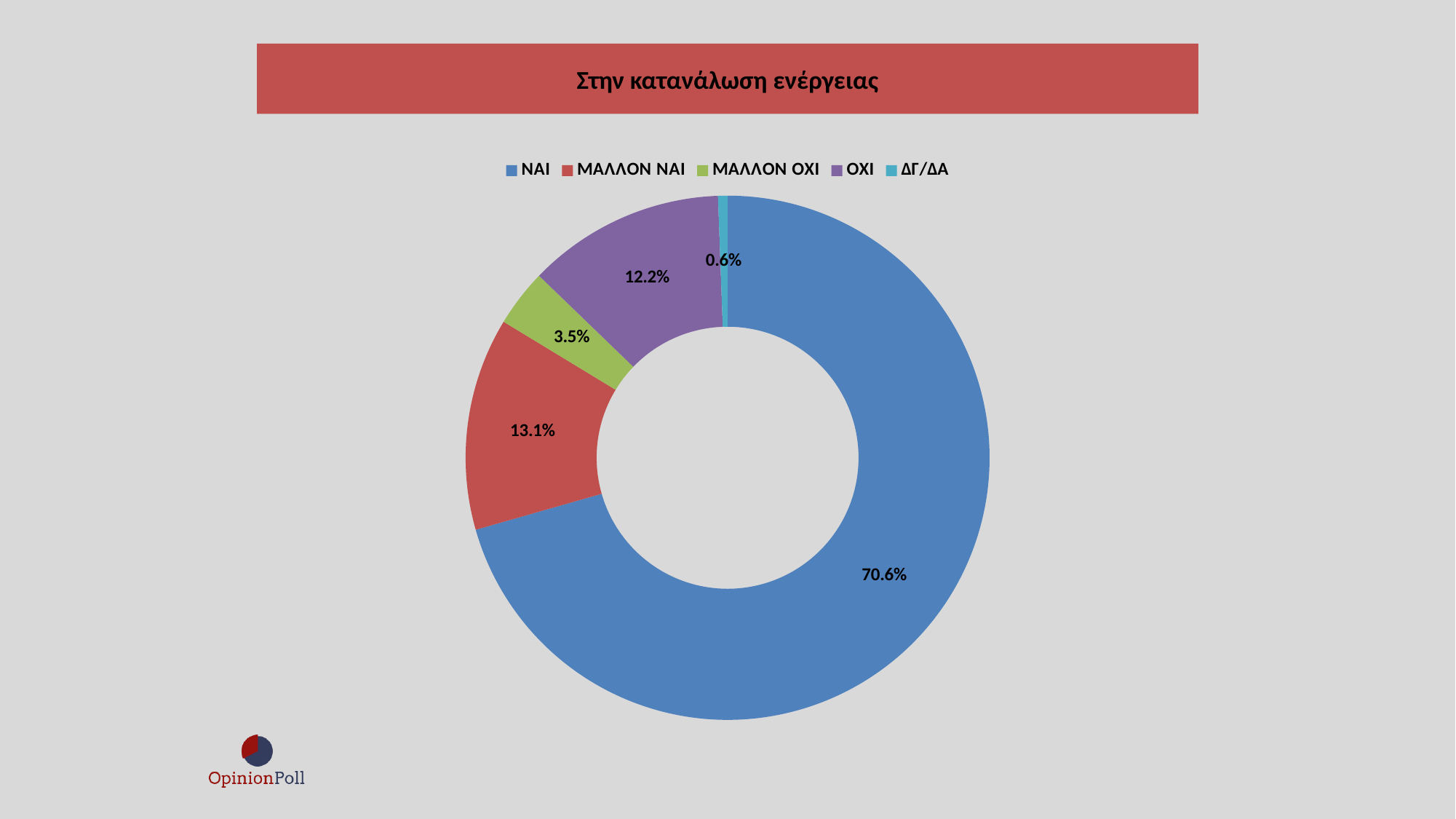
What percentage is shown for ΝΑΙ? 70.6% Which category has the largest share? ΝΑΙ What percentage is shown for ΜΑΛΛΟΝ ΟΧΙ? 3.5% What percentage is shown for ΔΓ/ΔΑ? 0.6% What percentage is shown for ΟΧΙ? 12.2% Which is larger, the share for ΜΑΛΛΟΝ ΟΧΙ or the share for ΟΧΙ? ΟΧΙ What is the difference between the shares of ΜΑΛΛΟΝ ΝΑΙ and ΟΧΙ? 0.9% What is the title of the chart? Στην κατανάλωση ενέργειας What kind of chart is shown on the slide? Doughnut (pie) chart What percentage is shown for ΜΑΛΛΟΝ ΝΑΙ? 13.1% Which category has the smallest share? ΔΓ/ΔΑ How many categories does the chart show? 5